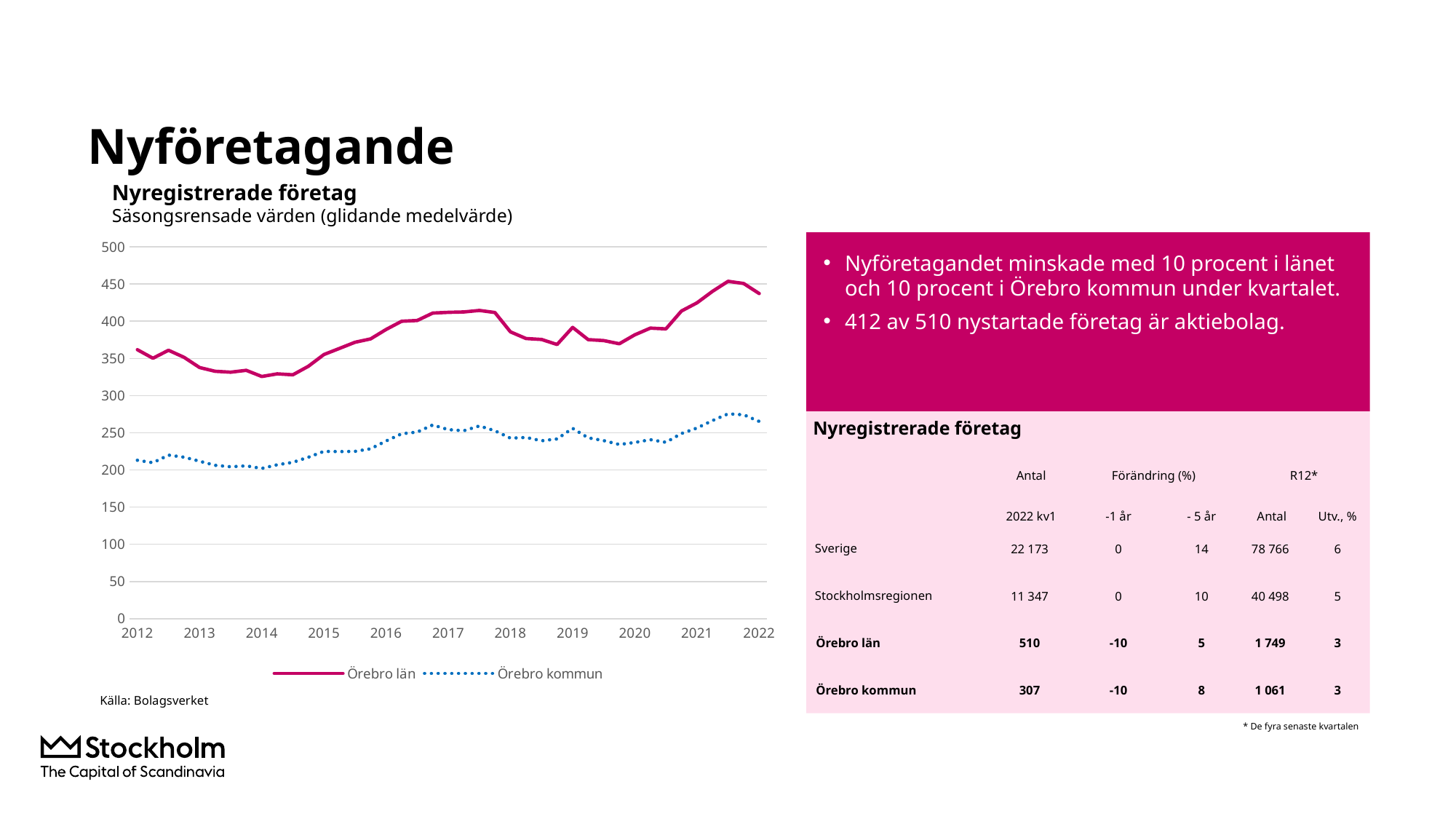
Which series has the higher value at 2022, Örebro län or Örebro kommun? Örebro län Is the value for Örebro kommun at 2014 greater or less than 250? less How many year labels are shown on the x axis of the chart? 11 Is the value for Örebro kommun at 2022 greater or less than 300? less Is the value for Örebro län at 2022 greater or less than 400? greater Does the Örebro län line rise or fall between 2014 and 2017? Rise What is the title of the chart? Nyregistrerade företag How many series does the chart legend list? 2 What are the two series named in the chart legend? Örebro län and Örebro kommun What kind of chart is shown on the slide? Line chart